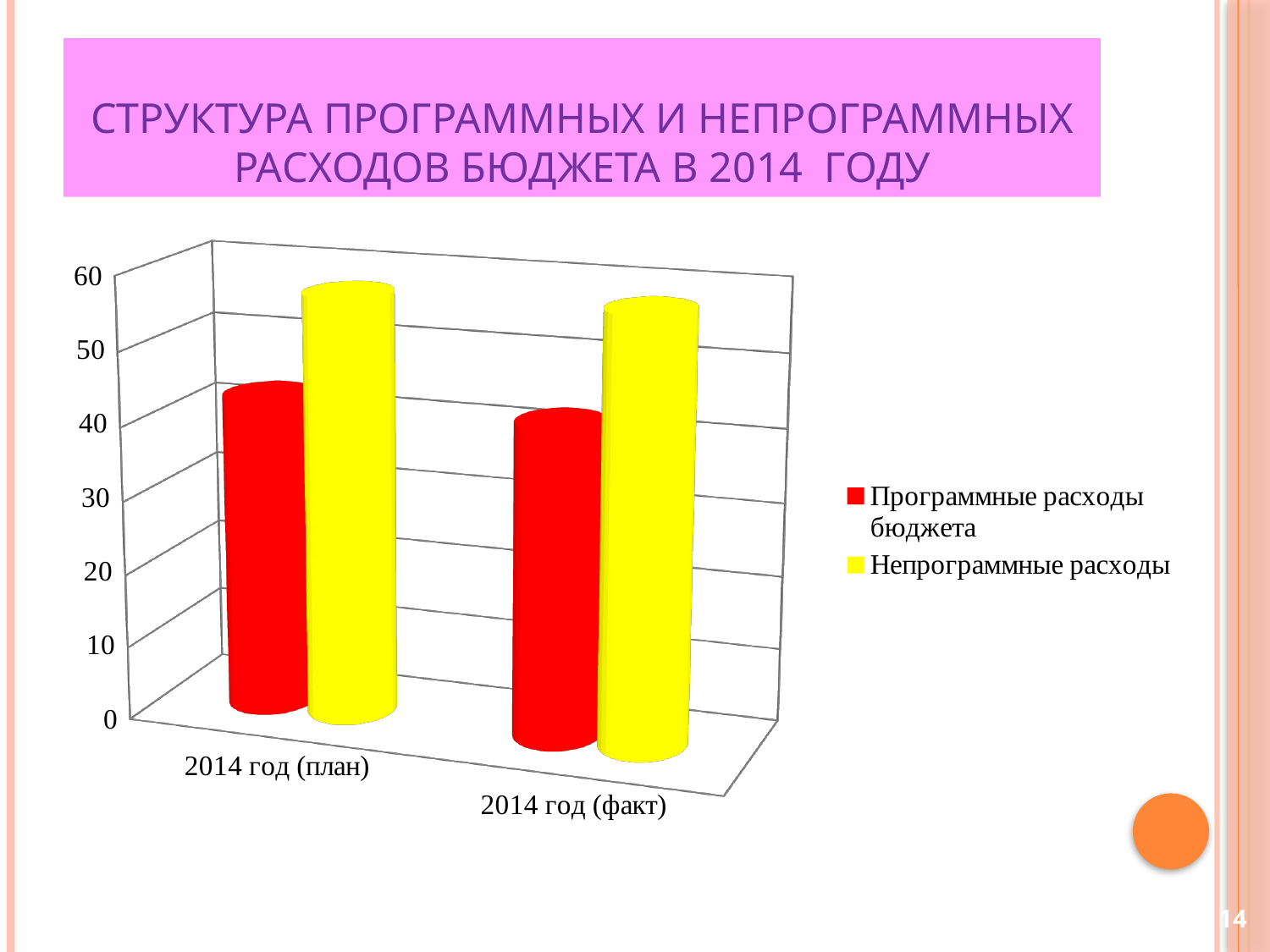
Which series is shown in yellow in the chart? Непрограммные расходы Which series is shown in red in the chart? Программные расходы бюджета How many series does the chart legend list? 2 For 2014 год (план), which is larger: Программные расходы бюджета or Непрограммные расходы? Непрограммные расходы How many categories are shown on the x axis of the chart? 2 Is the value of Программные расходы бюджета for 2014 год (факт) greater or less than 30? greater What kind of chart is shown on the slide? bar chart For 2014 год (факт), which is larger: Программные расходы бюджета or Непрограммные расходы? Непрограммные расходы Is the value of Непрограммные расходы for 2014 год (факт) greater or less than 50? greater Is the value of Программные расходы бюджета for 2014 год (план) greater or less than 50? less What is the highest value shown on the vertical axis of the chart? 60